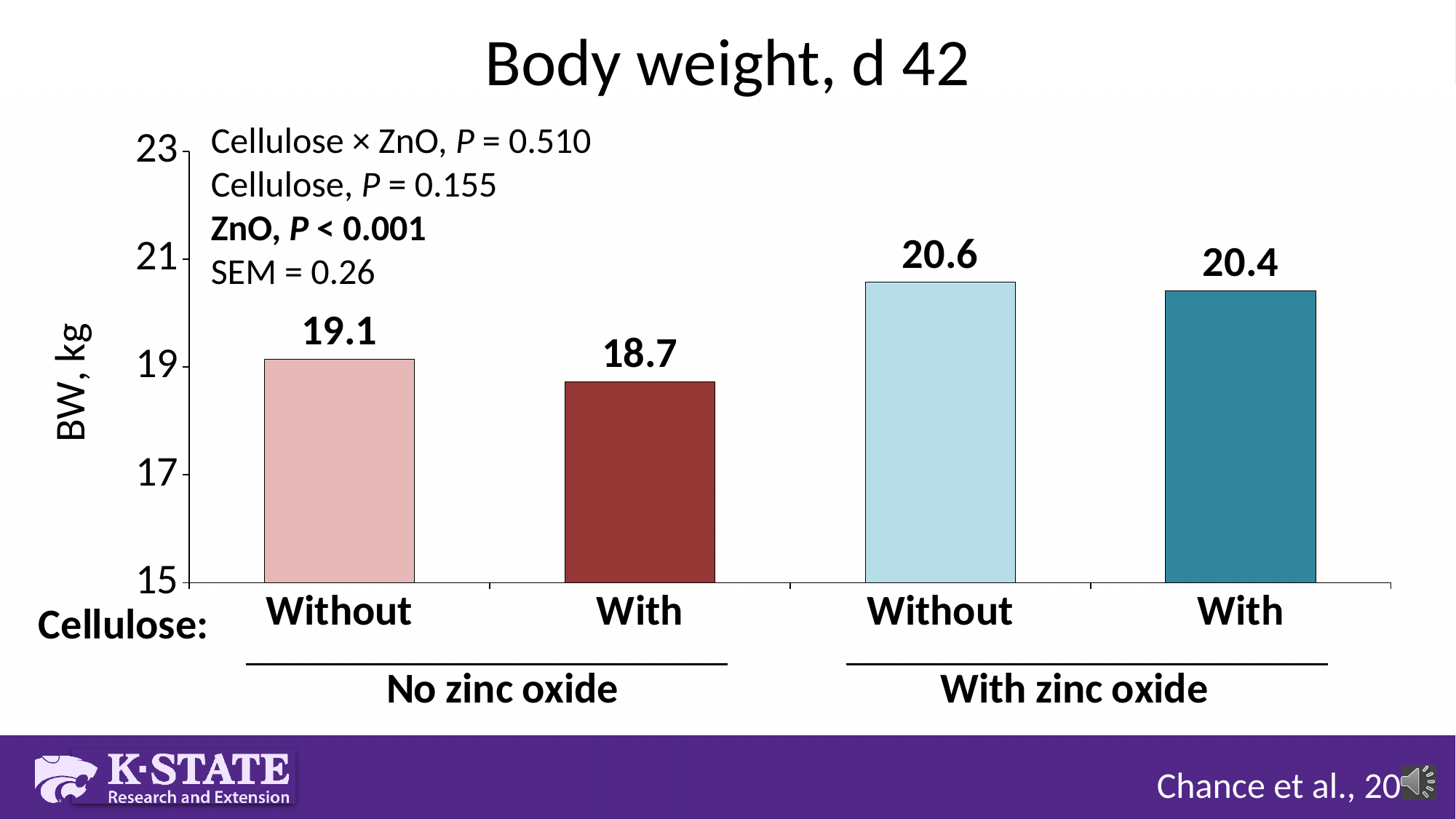
What is the difference in body weight between the without-cellulose and with-cellulose groups under no zinc oxide? 0.4 What type of chart is shown on the slide? Bar chart Which is larger: body weight for without cellulose with zinc oxide, or with cellulose with zinc oxide? Without cellulose with zinc oxide What is the body weight at d 42 for the group with cellulose and with zinc oxide? 20.4 What is the body weight at d 42 for the group without cellulose and no zinc oxide? 19.1 What is the P-value for the ZnO effect shown on the chart? P < 0.001 Is the body weight for the with-cellulose, no zinc oxide group greater or less than 19? less Which group has the highest body weight at d 42? Without cellulose, with zinc oxide What is the body weight at d 42 for the group with cellulose and no zinc oxide? 18.7 Which group has the lowest body weight at d 42? With cellulose, no zinc oxide What is the difference in body weight between the without-cellulose groups with zinc oxide and with no zinc oxide? 1.5 How many bars are shown in the chart? 4